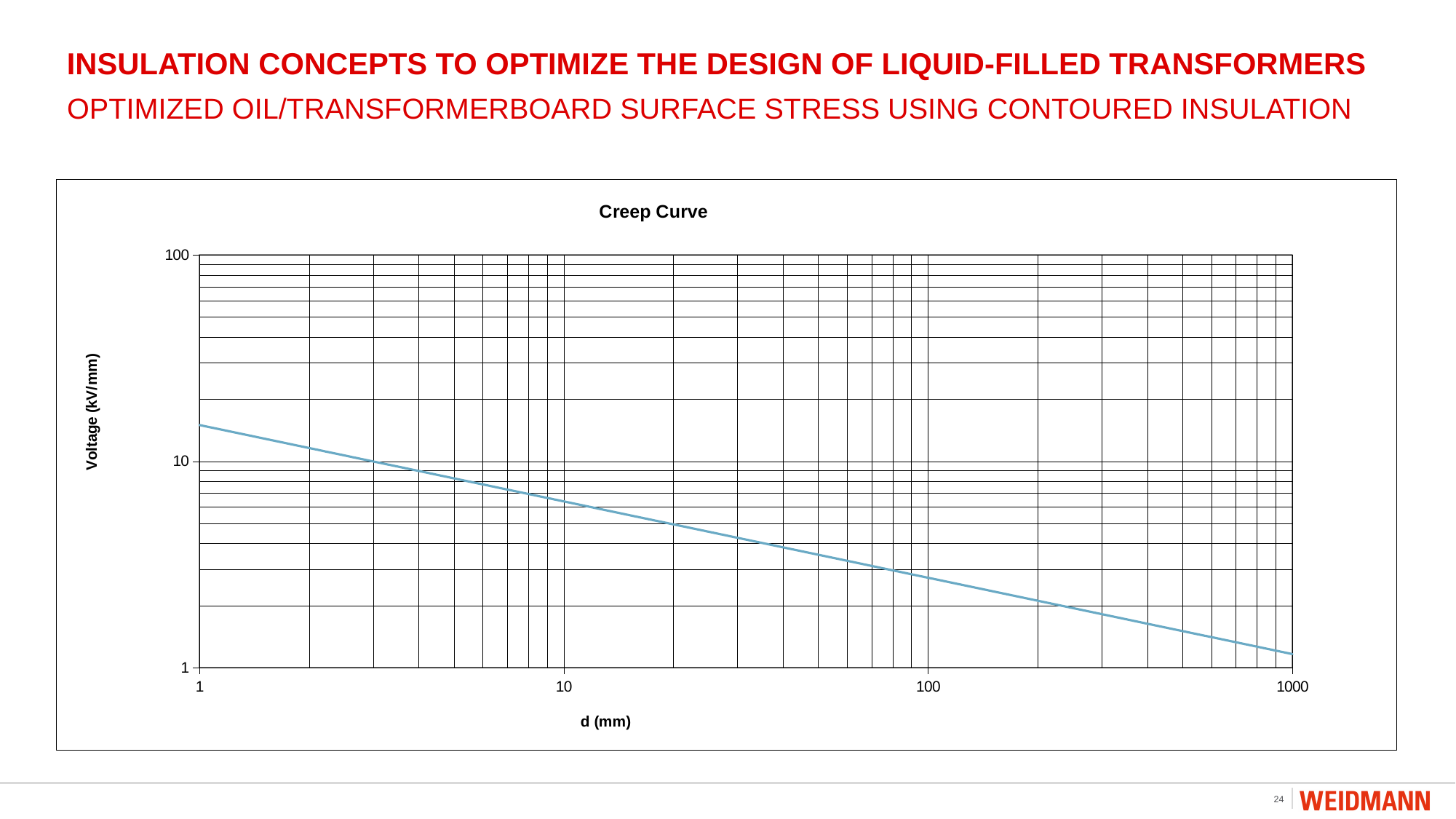
Is the voltage at d = 100 mm greater or less than 10 kV/mm? less Which has the higher voltage, d = 1 mm or d = 1000 mm? d = 1 mm Is the voltage at d = 1000 mm greater or less than 10 kV/mm? less Is the voltage at d = 10 mm greater or less than 10 kV/mm? less How many lines are plotted on the chart? 1 What is the title of the chart? Creep Curve What kind of chart is the Creep Curve? line chart Does the voltage rise or fall as d (mm) increases along the x axis? fall What is the label of the y axis? Voltage (kV/mm) At which end of the x axis is the voltage lowest, d = 1 mm or d = 1000 mm? d = 1000 mm